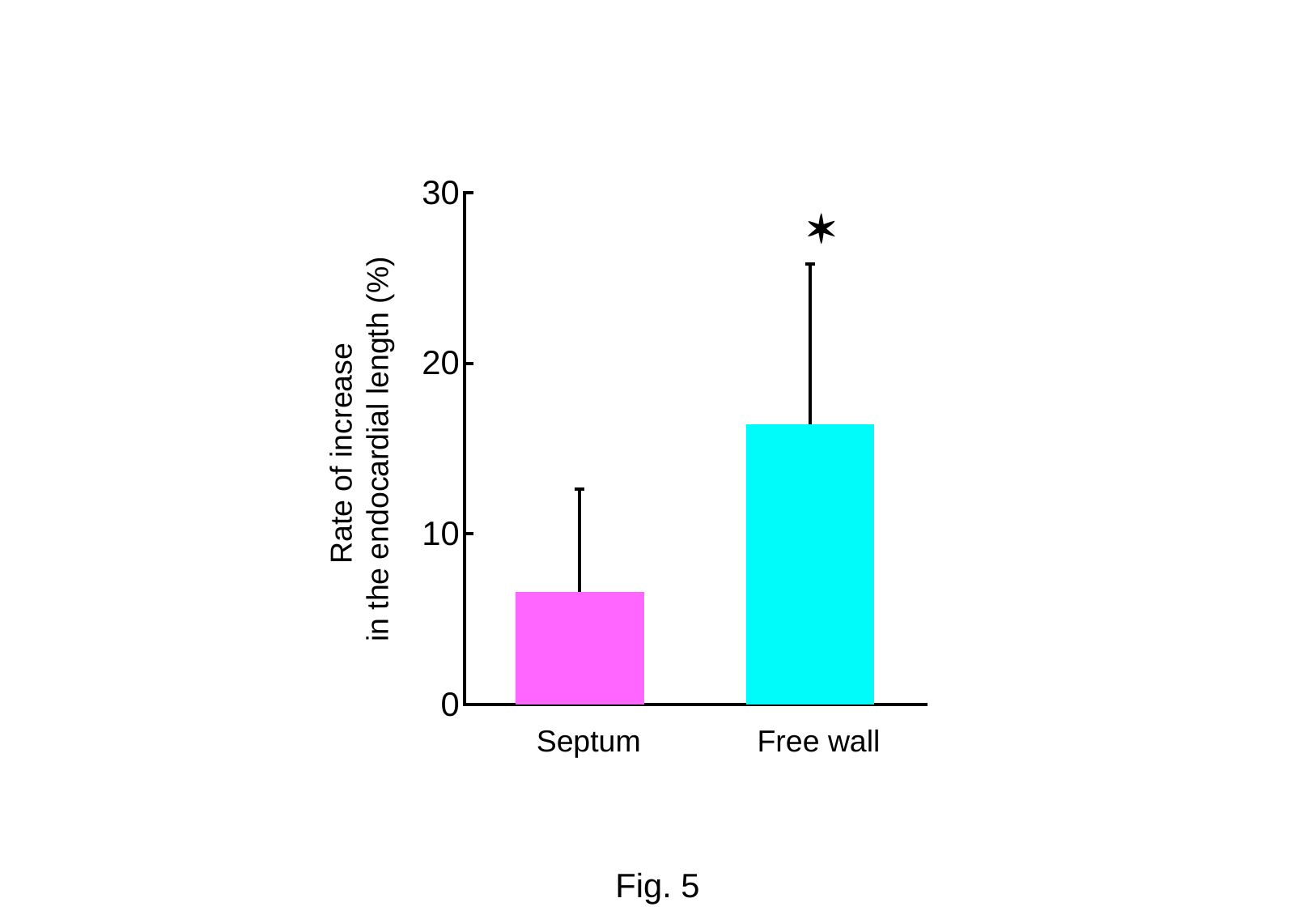
Which is larger, the value for Septum or the value for Free wall? Free wall What kind of chart is shown on the slide? bar chart How many categories are plotted on the x axis? 2 What colour is the bar for Free wall? cyan What is the highest tick value shown on the y axis? 30 Is the value for Free wall greater or less than 10? greater Which category has the highest rate of increase in the endocardial length? Free wall What is the label of the y axis? Rate of increase in the endocardial length (%) Is the value for Free wall greater or less than 20? less Is the value for Septum greater or less than 10? less Which category has the lowest rate of increase in the endocardial length? Septum